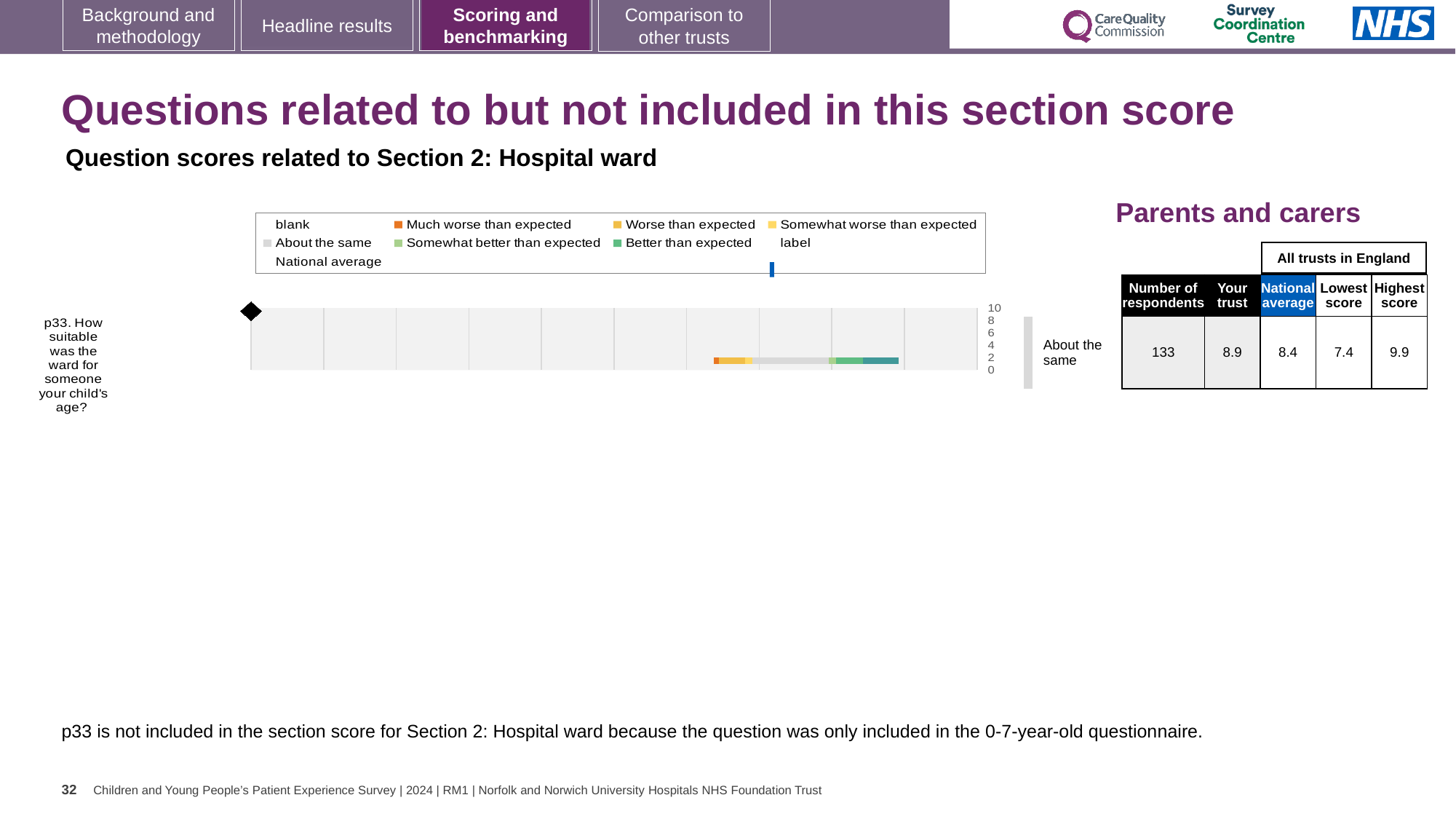
For p33, which is larger: the 'Your trust' score or the national average? Your trust How many questions are plotted in the chart? 1 In the Parents and carers table, what is the lowest score among all trusts in England for p33? 7.4 In the Parents and carers table, what is the national average score for p33? 8.4 In the Parents and carers table, what is the 'Your trust' score for p33? 8.9 For p33, what is the difference between the 'Your trust' score and the national average? 0.5 In the Parents and carers table, what is the highest score among all trusts in England for p33? 9.9 For p33, what is the difference between the highest score and the lowest score among all trusts in England? 2.5 What comparison category label is shown to the right of the p33 bar? About the same What kind of chart is used to show the p33 question score? bar chart What is the full label of the question plotted in the chart? p33. How suitable was the ward for someone your child's age? How many respondents are listed for p33 in the Parents and carers table? 133